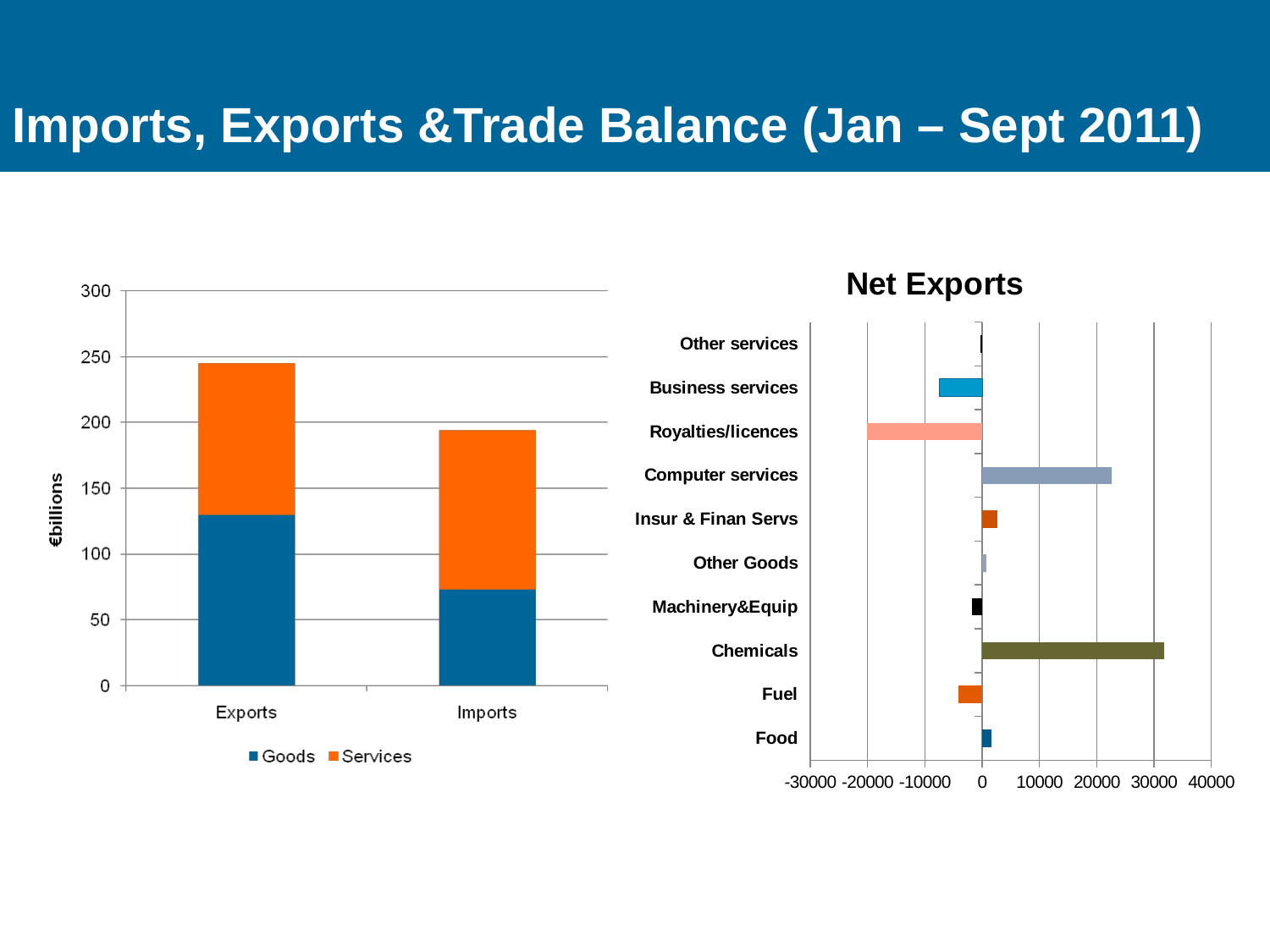
In the Net Exports chart, which category has the highest value? Chemicals What is the title of the right chart? Net Exports How many series does the legend of the left chart list? 2 In the Net Exports chart, which category has the lowest value? Royalties/licences In the left chart, which category has the larger Goods value, Exports or Imports? Exports In the Net Exports chart, is the value for Computer services greater or less than 20000? greater In the left chart, is the Goods value for Exports greater or less than 100? greater In the left chart, is the total value for Imports greater or less than 200? less What kind of chart is the left chart on the slide? bar chart How many categories are shown in the Net Exports chart? 10